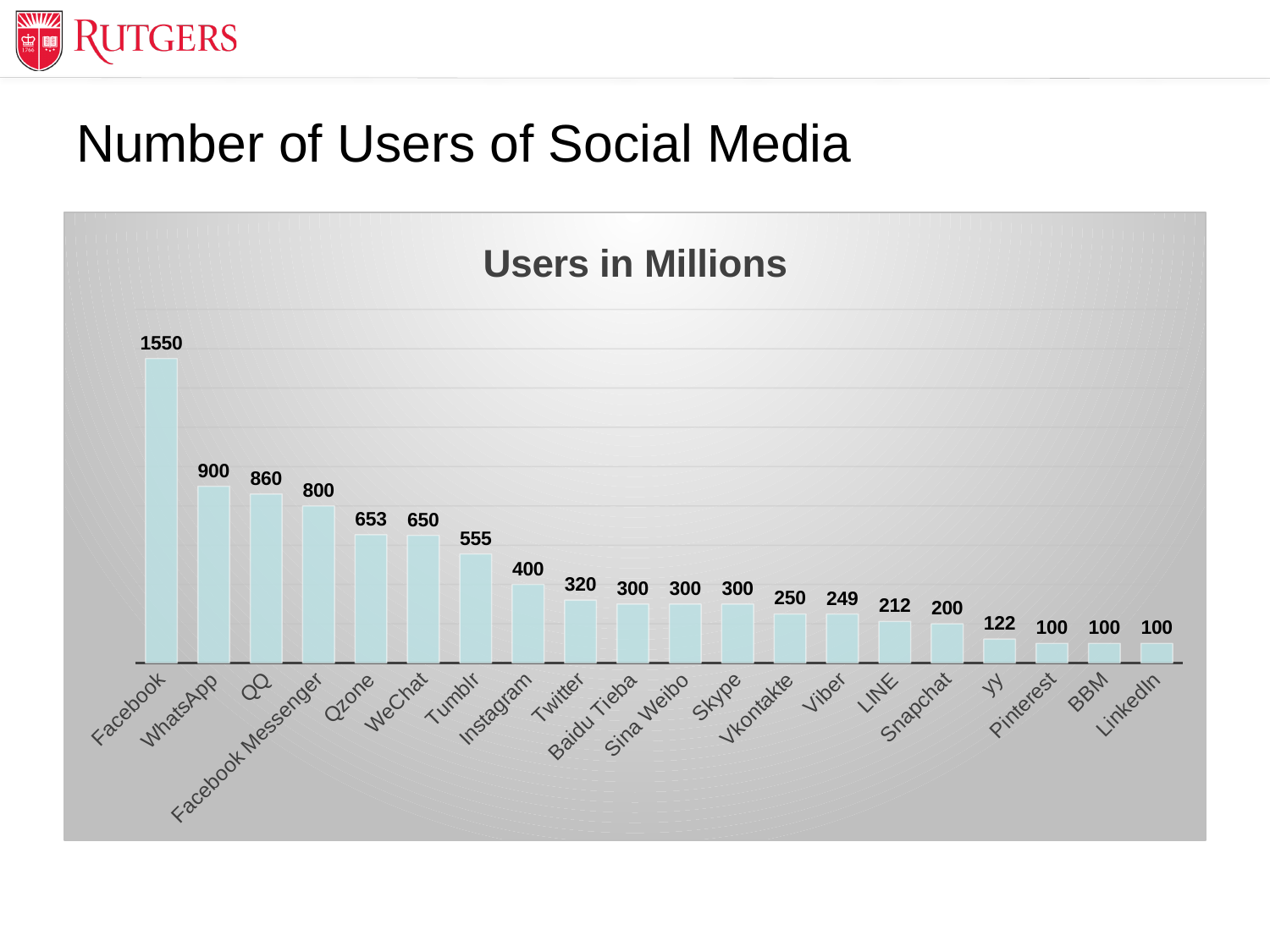
What is the value for Facebook? 1550 What is the value for Snapchat? 200 Which category has the highest value? Facebook Which is larger, the value for QQ or the value for Facebook Messenger? QQ How many categories are shown on the x axis? 20 What is the value for Qzone? 653 What is the value for yy? 122 What is the title of the chart? Users in Millions What is the difference between the values for Facebook and WhatsApp? 650 What kind of chart is shown on the slide? Bar chart What is the difference between the values for Tumblr and Instagram? 155 What is the value for WhatsApp? 900